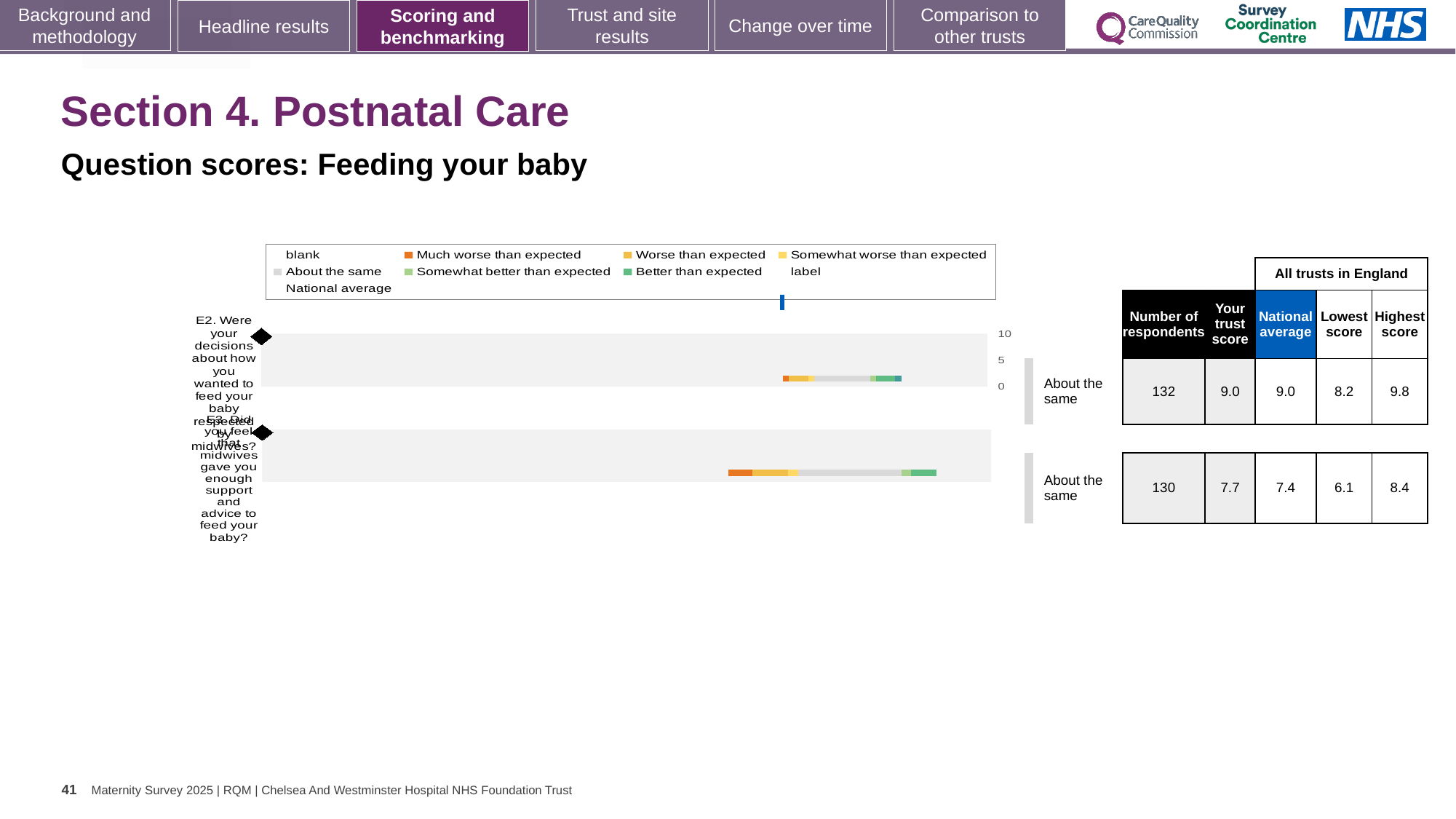
How many entries does the chart legend list? 9 What kind of chart is shown on the slide? bar chart What colour represents 'About the same' in the chart legend? grey What colour represents 'Much worse than expected' in the chart legend? orange How many questions (categories) are plotted in the chart? 2 In the table beside the chart, what is the lowest score among all trusts in England for question E3? 6.1 By how much does the trust score for question E3 exceed the national average for E3 in the table beside the chart? 0.3 In the table beside the chart, what is the number of respondents for question E2? 132 Which question has the higher trust score in the table beside the chart, E2 or E3? E2 In the table beside the chart, what is the national average for question E3? 7.4 In the table beside the chart, what is the trust score for question E3 (midwives gave enough support and advice to feed your baby)? 7.7 In the table beside the chart, what is the highest score among all trusts in England for question E2? 9.8